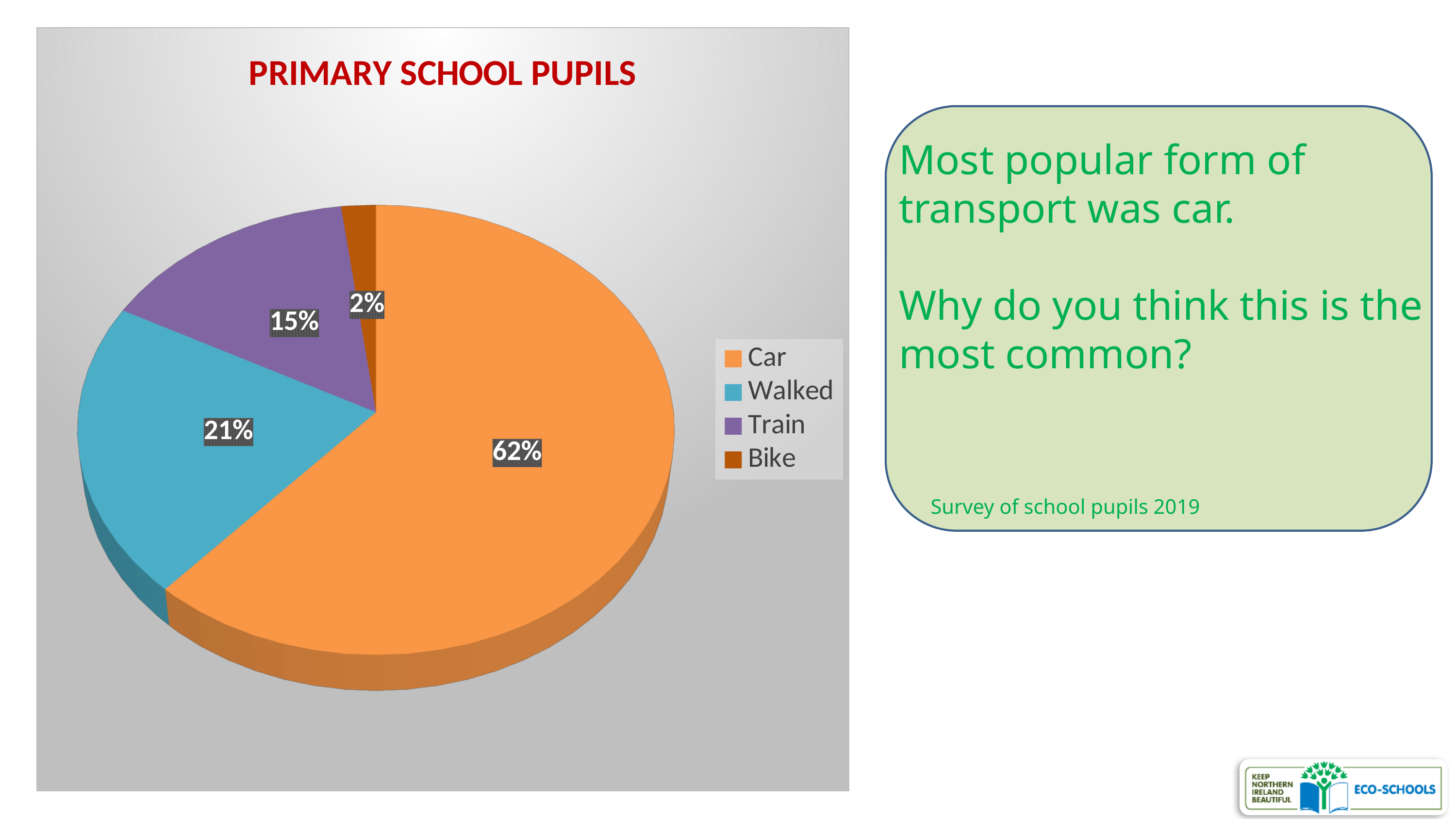
Which has a larger share, Train or Walked? Walked Which form of transport has the smallest share of the pie? Bike What percentage of primary school pupils travelled by car? 62% What is the difference in percentage points between Car and Walked? 41 What percentage of primary school pupils travelled by bike? 2% What percentage of primary school pupils travelled by train? 15% How many categories are shown in the pie chart? 4 What is the title of the chart? PRIMARY SCHOOL PUPILS What kind of chart is shown on the slide? Pie chart What is the difference in percentage points between Walked and Train? 6 What percentage of primary school pupils walked? 21% Which form of transport has the largest share of the pie? Car